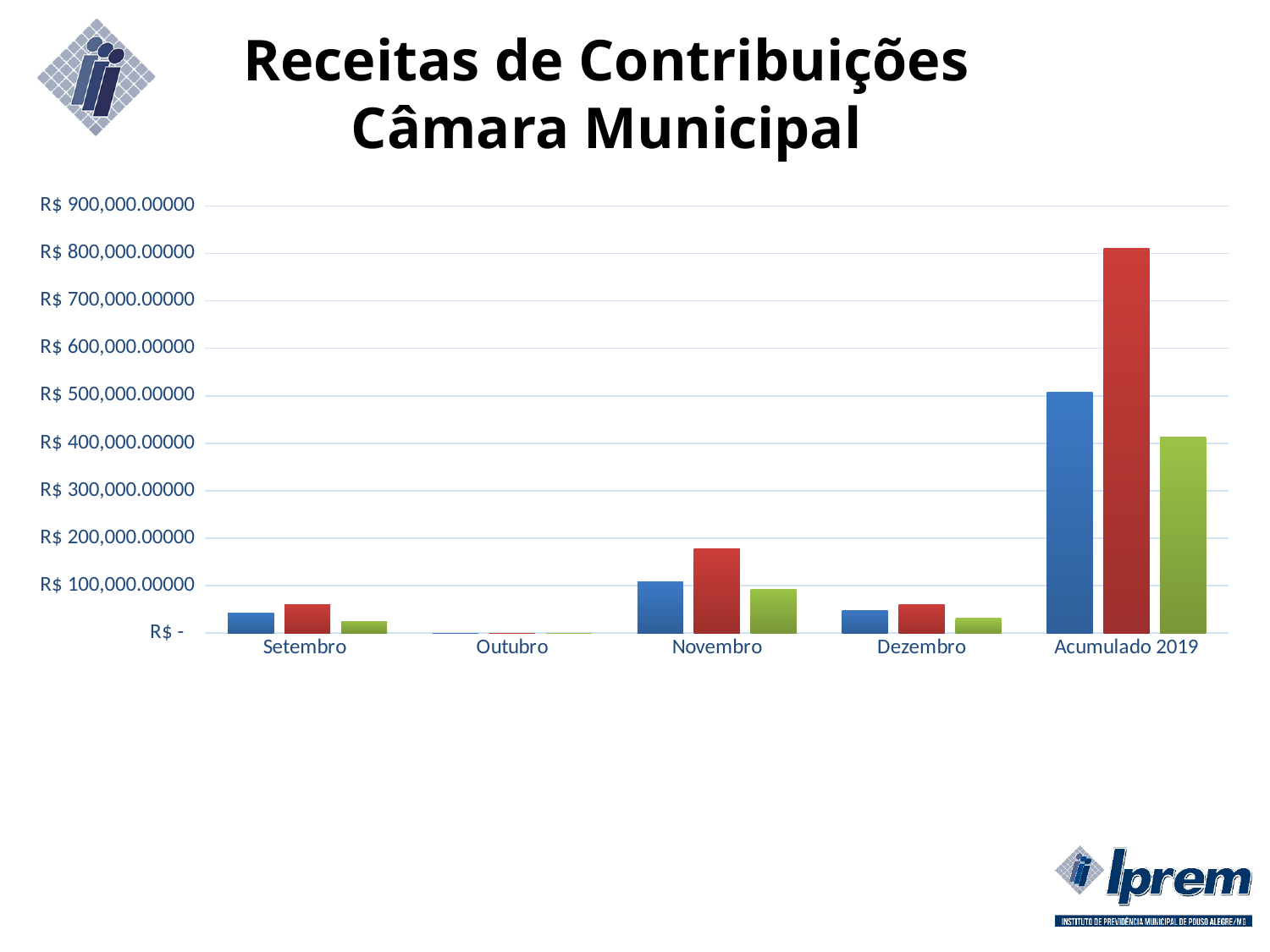
Is the value of the red bar for Novembro greater or less than R$ 200,000.00000? less Which category has the taller red bar, Novembro or Dezembro? Novembro Is the value of the blue bar for Acumulado 2019 greater or less than R$ 400,000.00000? greater Which category has the tallest bars on the chart? Acumulado 2019 How many bars are plotted for each category on the chart? 3 In the Acumulado 2019 category, which bar is taller, the red bar or the blue bar? the red bar What is the title of the chart on the slide? Receitas de Contribuições Câmara Municipal Is the value of the green bar for Acumulado 2019 greater or less than R$ 500,000.00000? less Which category has the smallest bars on the chart? Outubro How many categories are shown on the x axis of the chart? 5 What kind of chart is shown on the slide? bar chart